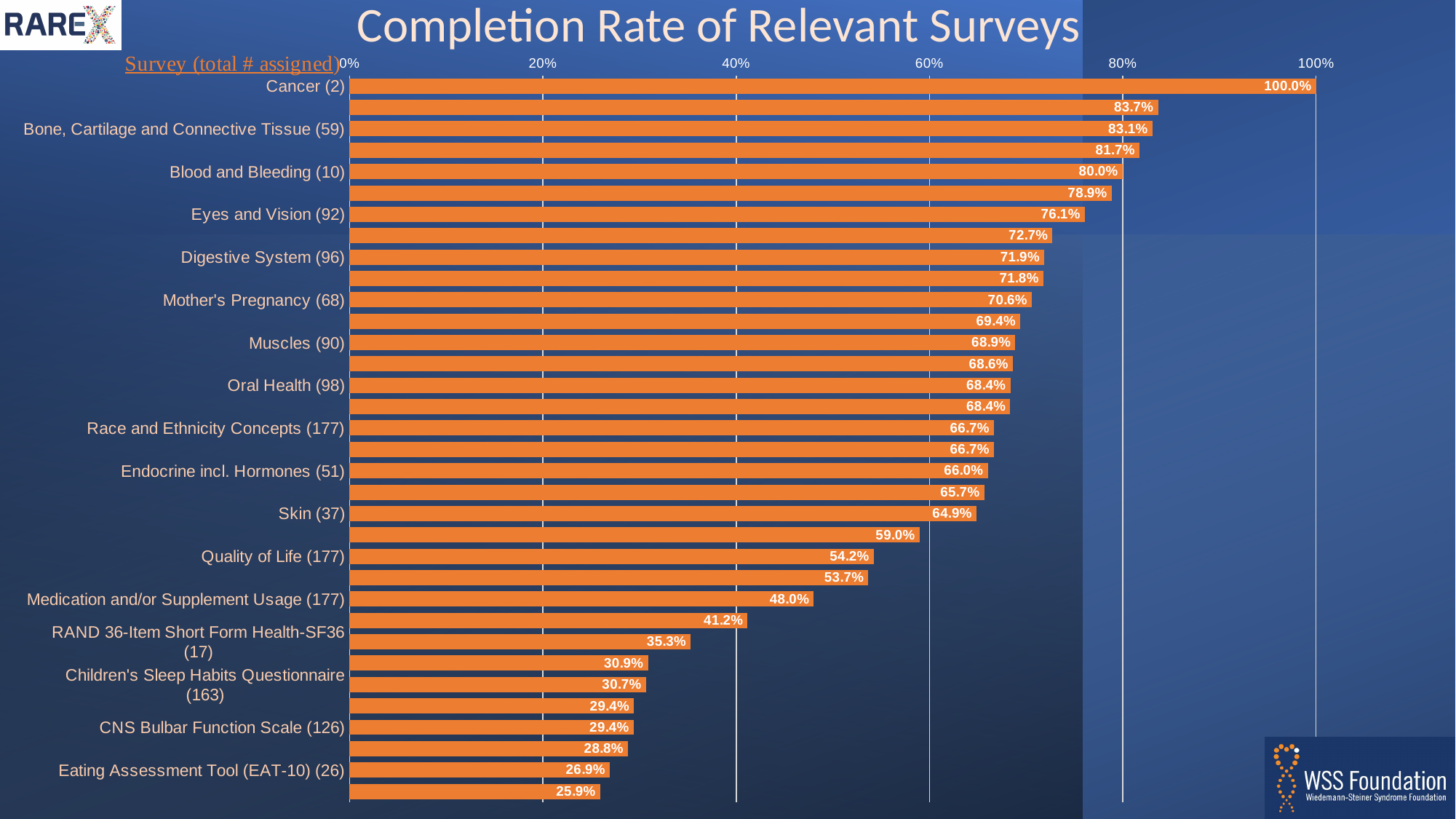
Which survey has the highest completion rate? Cancer (2) What type of chart is shown on the slide? bar chart What is the title of the chart? Completion Rate of Relevant Surveys What is the completion rate for Eyes and Vision (92)? 76.1% Which has a higher completion rate, Muscles (90) or Medication and/or Supplement Usage (177)? Muscles (90) What is the difference between the completion rates of Blood and Bleeding (10) and Skin (37)? 15.1% What is the lowest completion rate shown on the chart? 25.9% Is the completion rate for Children's Sleep Habits Questionnaire (163) greater or less than 40%? less How many bars are plotted on the chart? 34 What is the completion rate for Eating Assessment Tool (EAT-10) (26)? 26.9% What is the completion rate for Cancer (2)? 100.0% What is the completion rate for Quality of Life (177)? 54.2%